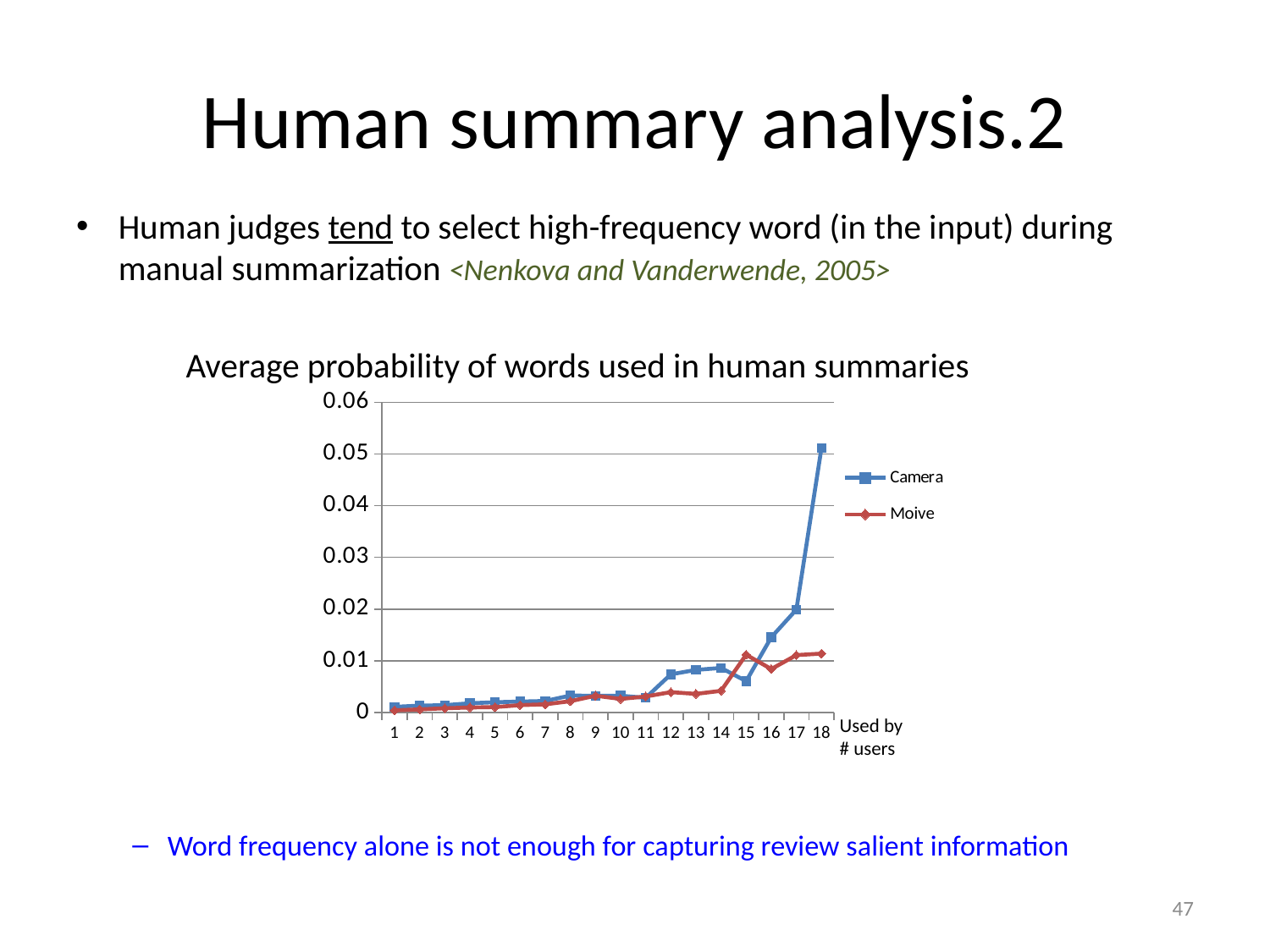
How many series does the legend list? 2 Is the Camera value at x = 17 greater or less than 0.01? greater Is the Moive value at x = 18 greater or less than 0.02? less Is the Camera value at x = 18 greater or less than 0.04? greater At which x-axis value does the Camera series reach its highest point? 18 At x = 18, which series has the larger value, Camera or Moive? Camera How many points are plotted along the x axis for each series? 18 What is the title of the chart? Average probability of words used in human summaries What kind of chart is shown on the slide? line chart At x = 15, which series has the larger value, Camera or Moive? Moive What are the two series named in the legend? Camera and Moive Do the Camera values generally rise or fall as the x-axis value increases from 1 to 18? rise